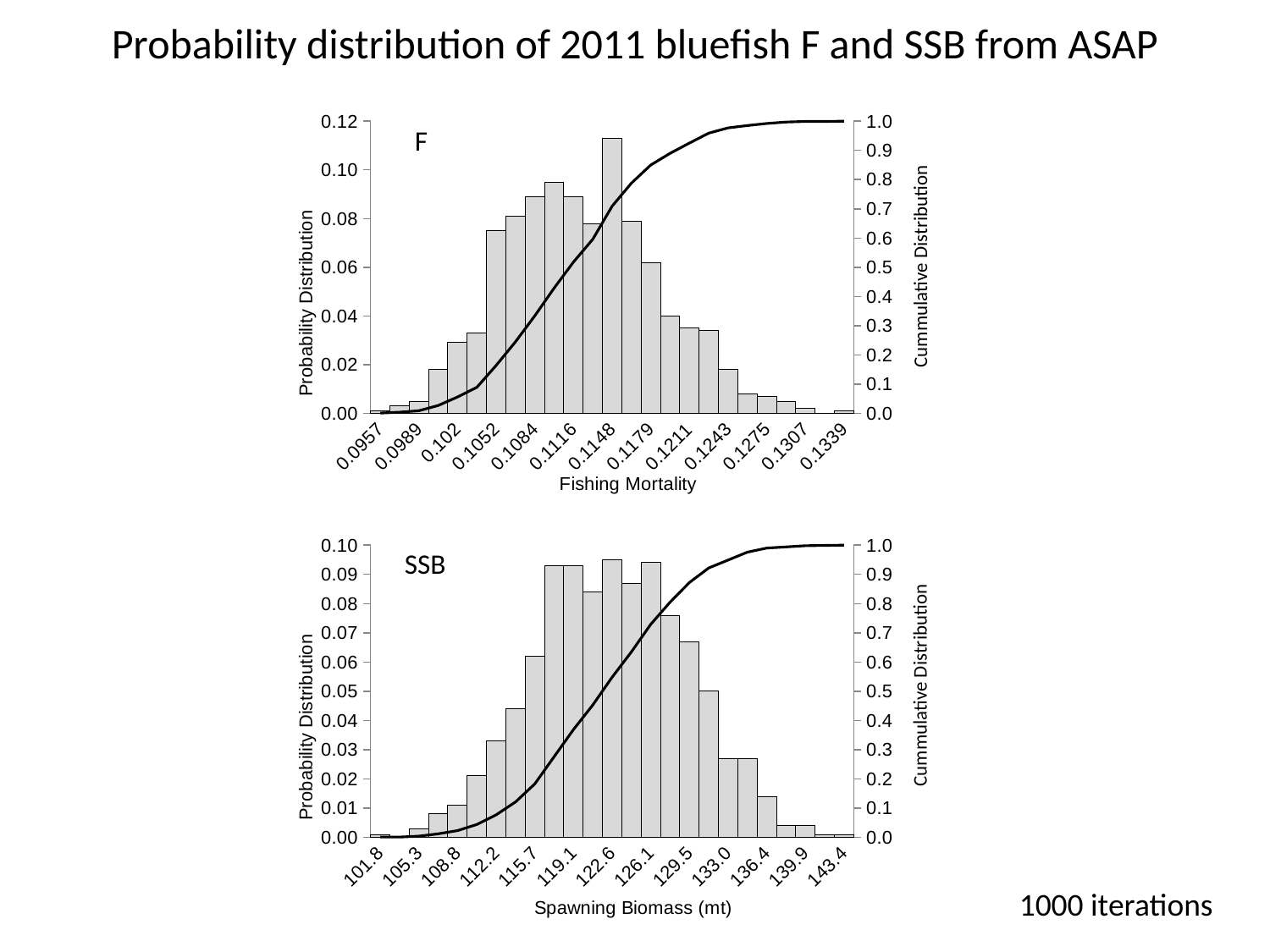
In the bottom chart (SSB), is the bar at 136.4 greater or less than 0.02 on the Probability Distribution axis? less What is the title of the right-hand vertical axis on the bottom chart (SSB)? Cummulative Distribution In the bottom chart (SSB), is the bar at 112.2 greater or less than 0.04 on the Probability Distribution axis? less In the top chart (F), is the bar at 0.1275 greater or less than 0.02 on the Probability Distribution axis? less How many Spawning Biomass labels are shown on the x axis of the bottom chart (SSB)? 13 In the top chart (F), at which Fishing Mortality label is the tallest bar? 0.1148 In the bottom chart (SSB), which bar is taller, the one at 129.5 or the one at 133.0? 129.5 In the top chart (F), does the cumulative distribution line rise or fall as Fishing Mortality increases? rise What kind of chart is the top chart labelled F? bar chart with a cumulative line